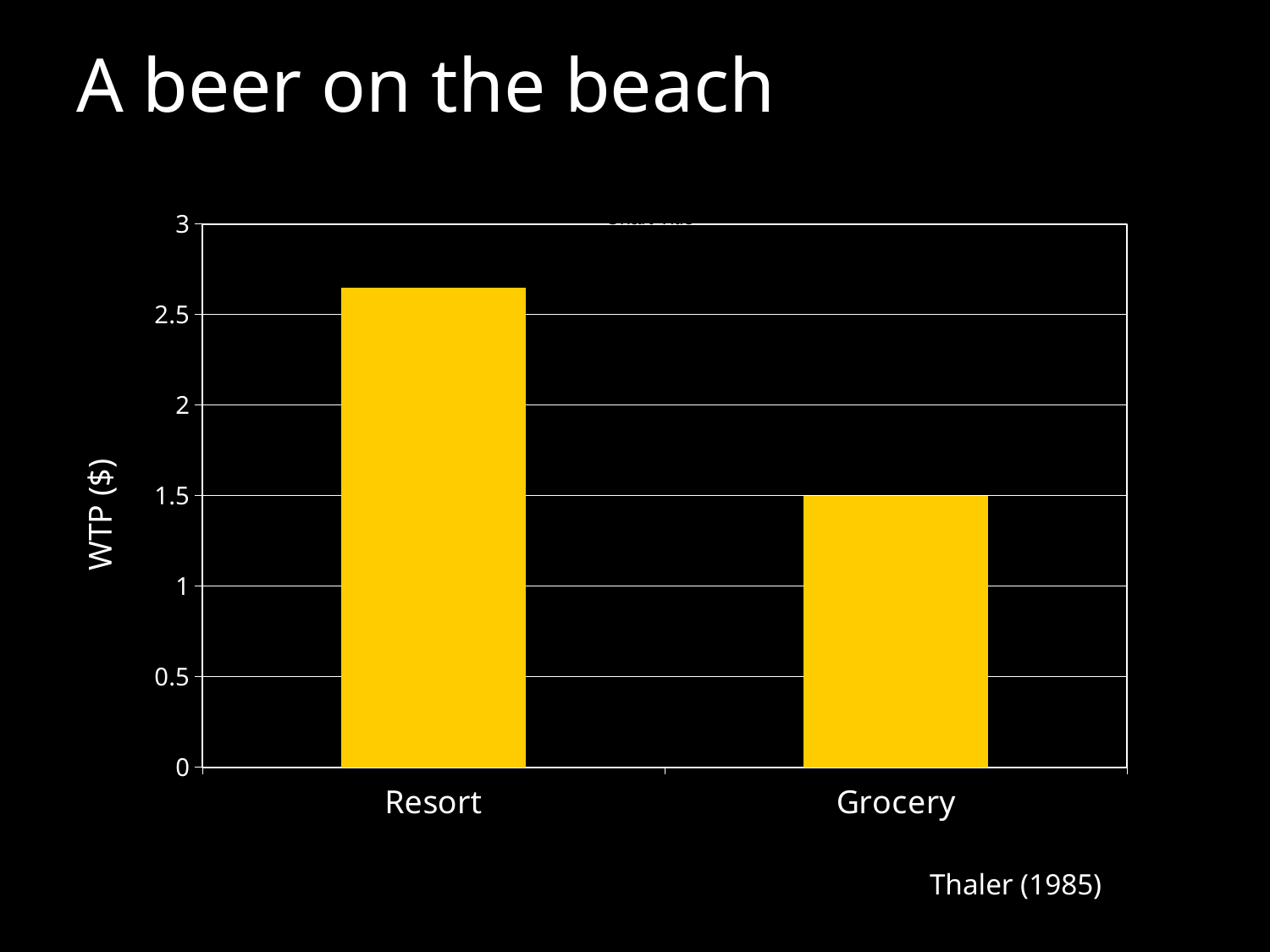
What is the label on the y axis of the chart? WTP ($) What colour are the bars in the chart? yellow Is the value for Resort greater or less than 3? less Is the value for Grocery greater or less than 2? less Which is larger, the value for Resort or the value for Grocery? Resort Which category has the lowest WTP value? Grocery What kind of chart is shown on the slide? bar chart Is the value for Resort greater or less than 2.5? greater Which category has the highest WTP value? Resort Do the values rise or fall from Resort to Grocery along the x axis? fall How many categories are shown on the x axis of the chart? 2 What is the WTP ($) value for Grocery? 1.5